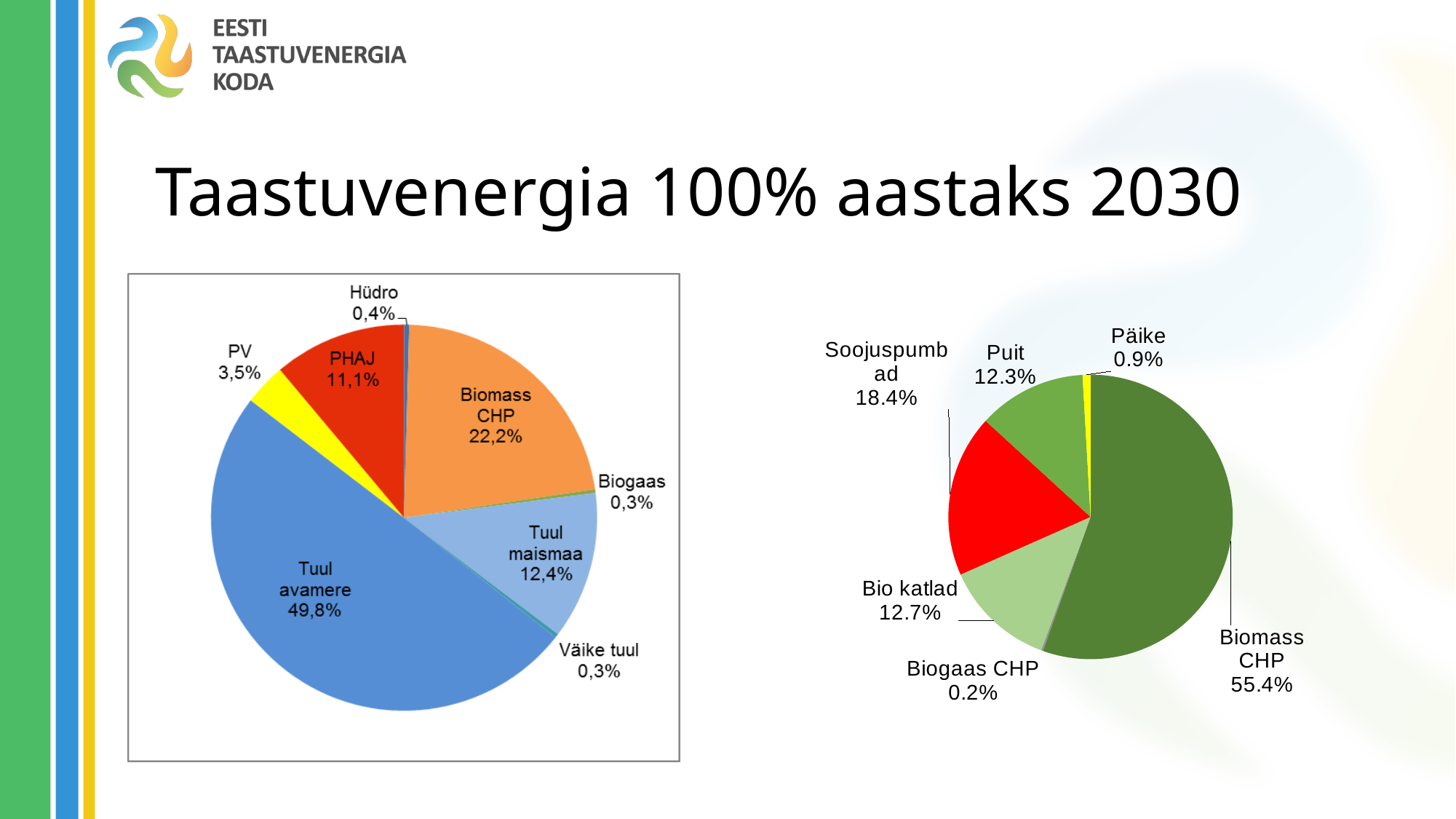
In the left pie chart, what share does Tuul avamere have? 49,8% What type of chart is shown on the right side of the slide? Pie chart In the right pie chart, what is the value for Soojuspumbad? 18.4% In the left pie chart, which is larger, PV or Hüdro? PV In the right pie chart, what is the difference between Bio katlad and Puit? 0.4% In the left pie chart, which category has the largest slice? Tuul avamere In the left pie chart, what is the value for Biomass CHP? 22,2% In the left pie chart, what is the difference between Tuul maismaa and PHAJ? 1,3% How many slices does the right pie chart have? 6 In the right pie chart, which category has the smallest slice? Biogaas CHP How many slices does the left pie chart have? 8 In the right pie chart, what share does Biomass CHP have? 55.4%